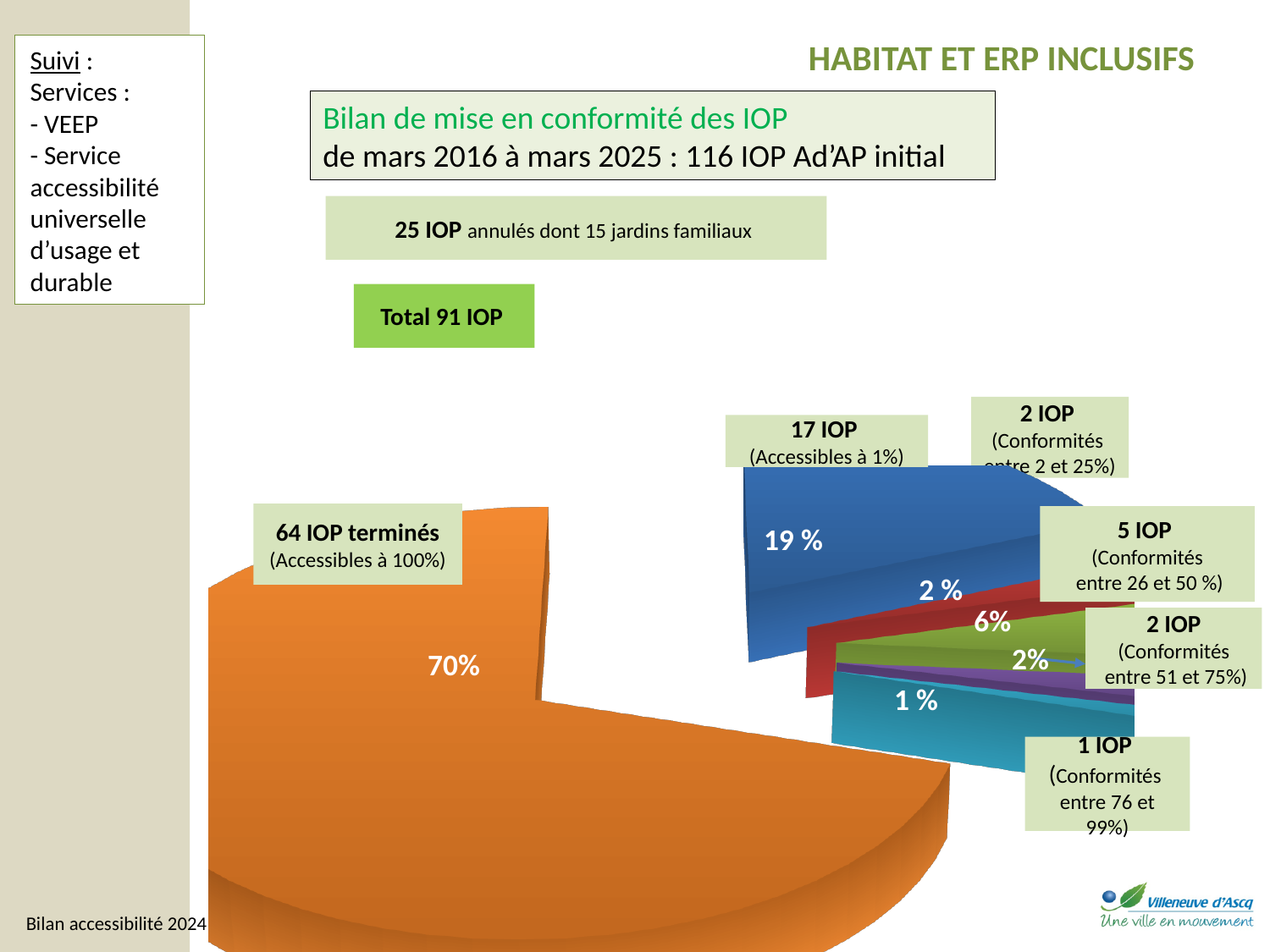
How many IOP are labelled as Accessibles à 1%? 17 IOP How many slices does the pie chart have? 6 Which has more IOP: Conformités entre 26 et 50 % or Conformités entre 2 et 25%? Conformités entre 26 et 50 % What kind of chart is shown on the slide? pie chart What total number of IOP is stated in the green box above the chart? Total 91 IOP Which category is the smallest slice of the pie? 1 IOP (Conformités entre 76 et 99%) What percentage of the pie corresponds to the 17 IOP Accessibles à 1%? 19 % What share of the pie do the 64 IOP terminés (Accessibles à 100%) represent? 70% What percentage is shown for the slice Conformités entre 26 et 50 %? 6% What is the difference between the number of IOP terminés and the number of IOP Accessibles à 1%? 47 How many IOP are in the category Conformités entre 51 et 75%? 2 IOP Which category is the largest slice of the pie? 64 IOP terminés (Accessibles à 100%)